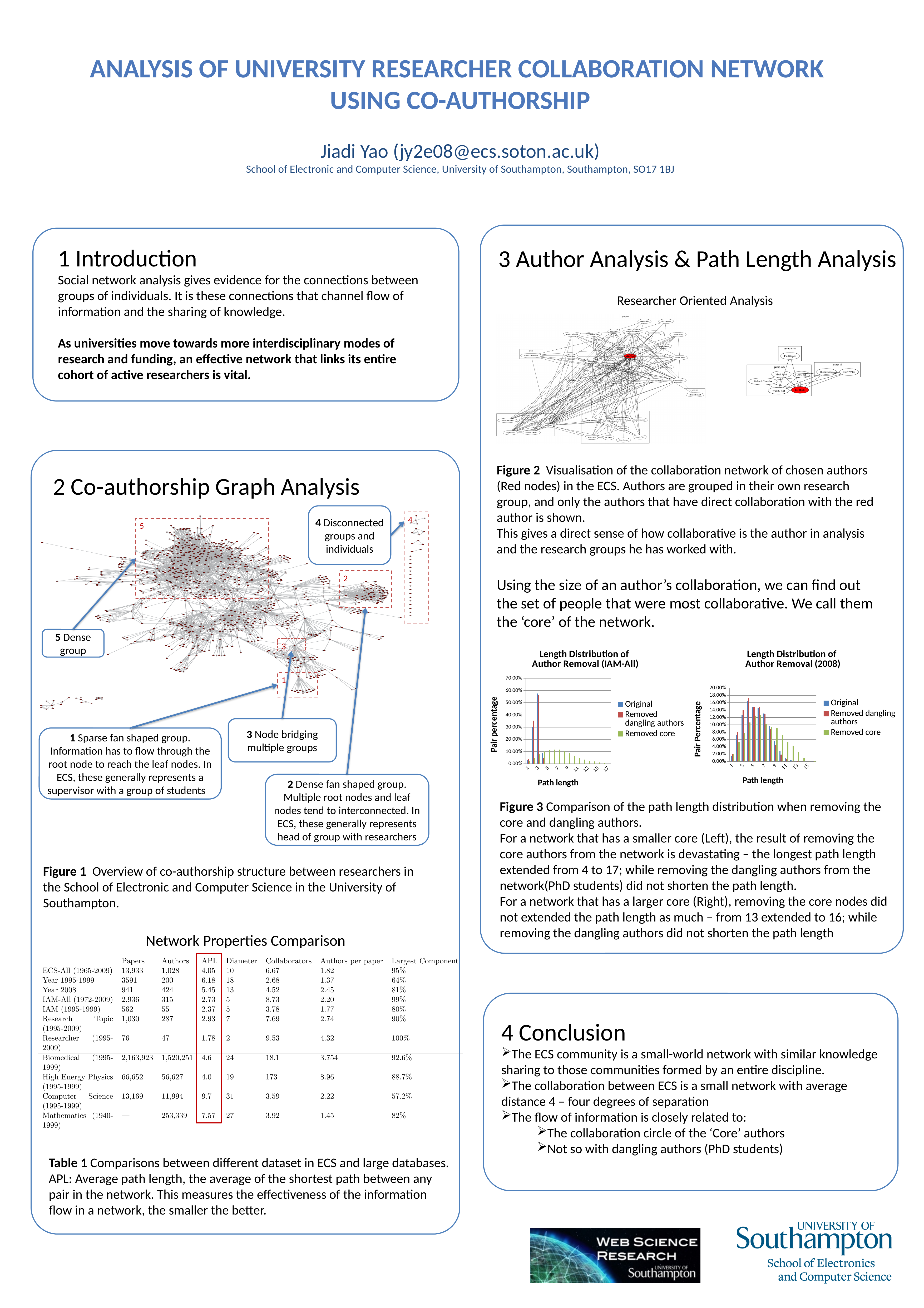
In the 'Length Distribution of Author Removal (IAM-All)' chart, is the Original value at path length 3 greater or less than 40.00%? greater How many series does the legend of the 'Length Distribution of Author Removal (2008)' chart list? 3 In the 'Length Distribution of Author Removal (2008)' chart, which is larger at path length 11: Removed core or Original? Removed core In the 'Length Distribution of Author Removal (2008)' chart, is the Removed core value at path length 15 greater or less than 4.00%? less In the 'Length Distribution of Author Removal (IAM-All)' chart, is the Removed core value at path length 3 greater or less than 30.00%? less What is the highest tick shown on the y axis of the 'Length Distribution of Author Removal (2008)' chart? 20.00% In the 'Length Distribution of Author Removal (IAM-All)' chart, do the Removed core values rise or fall from path length 7 to path length 17? fall What kind of chart is the 'Length Distribution of Author Removal (IAM-All)' chart? bar chart In the 'Length Distribution of Author Removal (IAM-All)' chart, at which path length does the Original series reach its highest value? 3 In the 'Length Distribution of Author Removal (IAM-All)' chart, what are the three legend entries? Original, Removed dangling authors, Removed core In the 'Length Distribution of Author Removal (IAM-All)' chart, which is larger at path length 3: Original or Removed core? Original